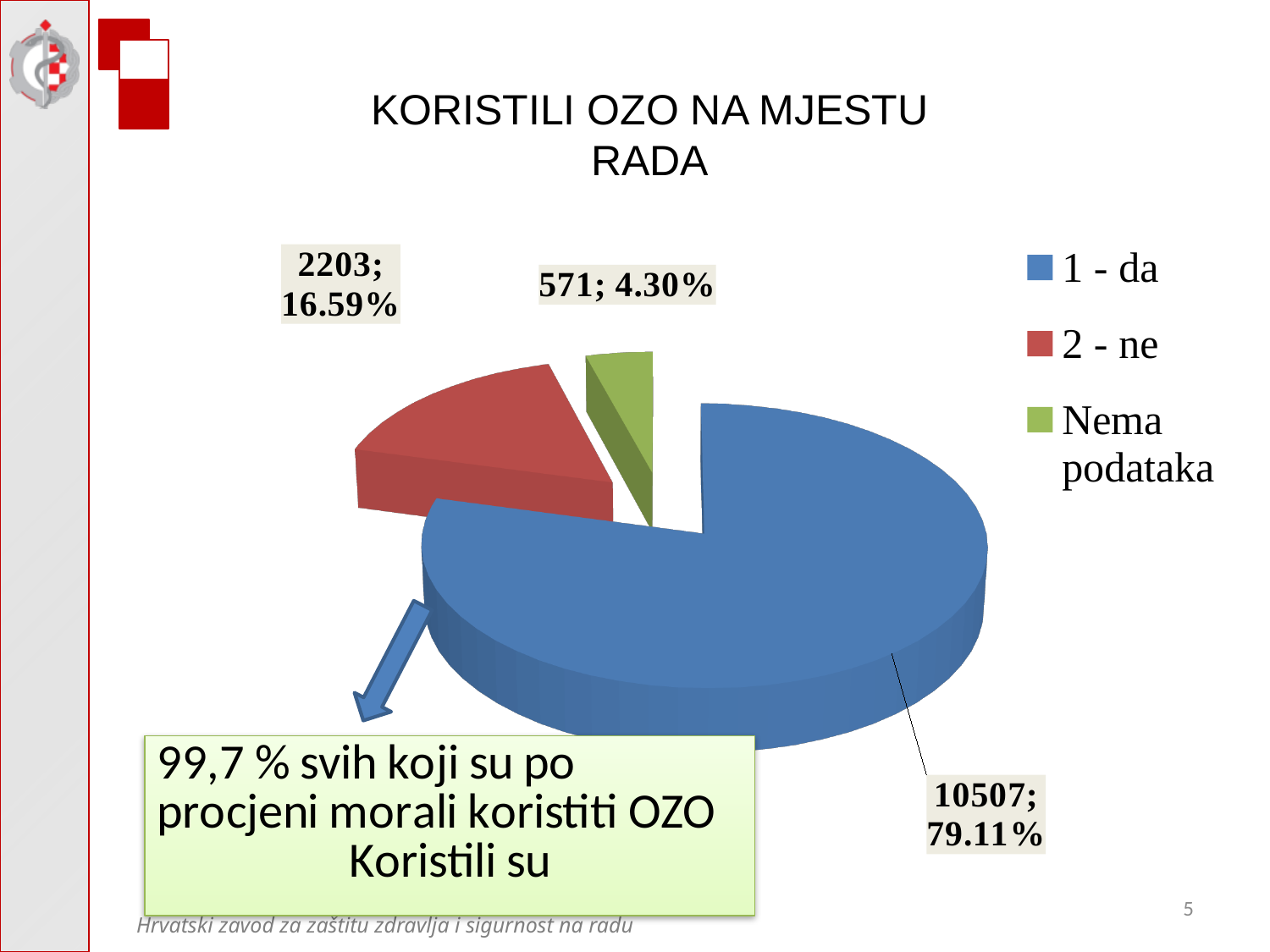
How many slices does the pie chart have? 3 How many entries does the legend list? 3 What share of the pie does the '1 - da' slice represent? 79.11% Which category has the smallest slice? Nema podataka Which category has the largest slice? 1 - da What kind of chart is shown on the slide? pie chart What share of the pie does the 'Nema podataka' slice represent? 4.30% What is the count for the '2 - ne' slice? 2203 What share of the pie does the '2 - ne' slice represent? 16.59% What is the count for the '1 - da' slice? 10507 What is the count for the 'Nema podataka' slice? 571 What is the difference in count between '2 - ne' and 'Nema podataka'? 1632